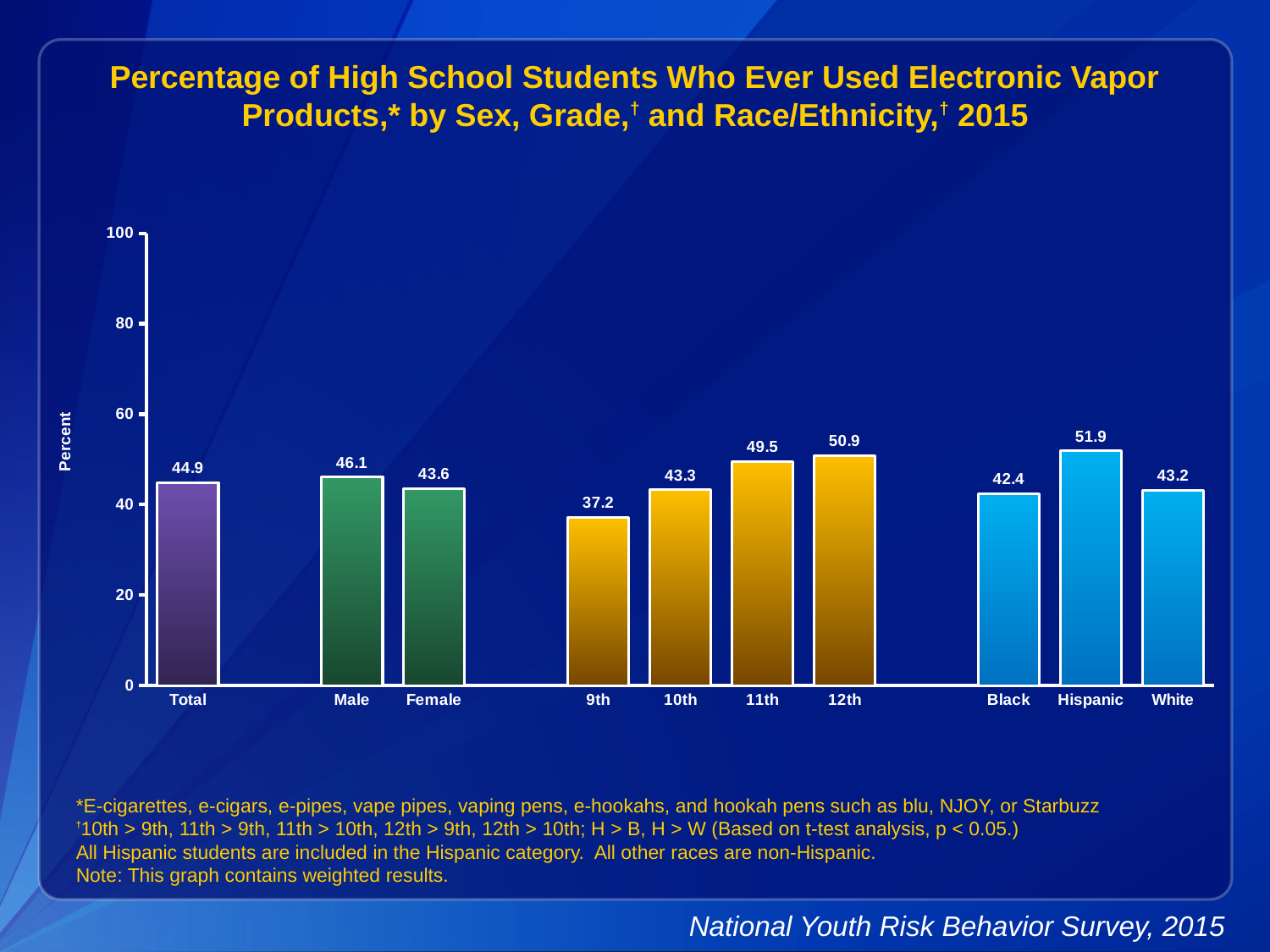
Which category has the highest value? Hispanic What is the value for Total? 44.9 What is the value for 9th grade students? 37.2 Which category has the lowest value? 9th Do the values rise or fall from 9th grade to 12th grade? rise What is the difference between the values for 12th and 9th grade? 13.7 What is the difference between the values for Male and Female? 2.5 Is the value for 11th grade greater or less than 40? greater How many categories are shown on the x axis? 10 What kind of chart is this? bar chart What is the value for Hispanic students? 51.9 Which is larger, the value for Black or the value for White? White